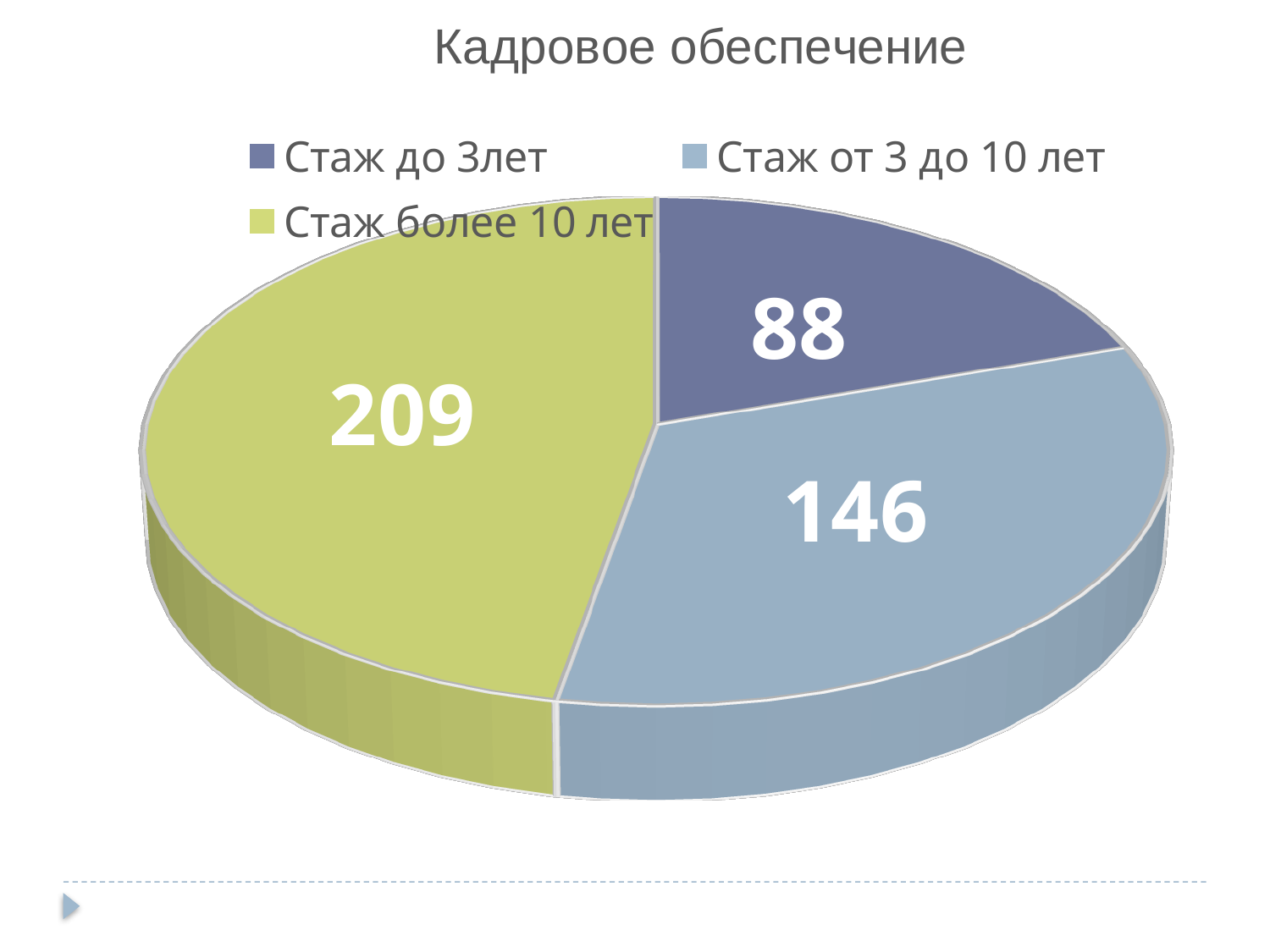
What is the difference between the values for "Стаж от 3 до 10 лет" and "Стаж до 3лет"? 58 How many categories does the pie chart have? 3 Which is larger: the value for "Стаж от 3 до 10 лет" or the value for "Стаж до 3лет"? Стаж от 3 до 10 лет What is the title of the chart? Кадровое обеспечение What type of chart is shown on the slide? pie chart What is the value for "Стаж до 3лет"? 88 What is the difference between the values for "Стаж более 10 лет" and "Стаж от 3 до 10 лет"? 63 Which category has the largest slice of the pie? Стаж более 10 лет What is the value for "Стаж более 10 лет"? 209 Which category has the smallest slice of the pie? Стаж до 3лет What is the value for "Стаж от 3 до 10 лет"? 146 What is the total of all slices in the pie chart? 443